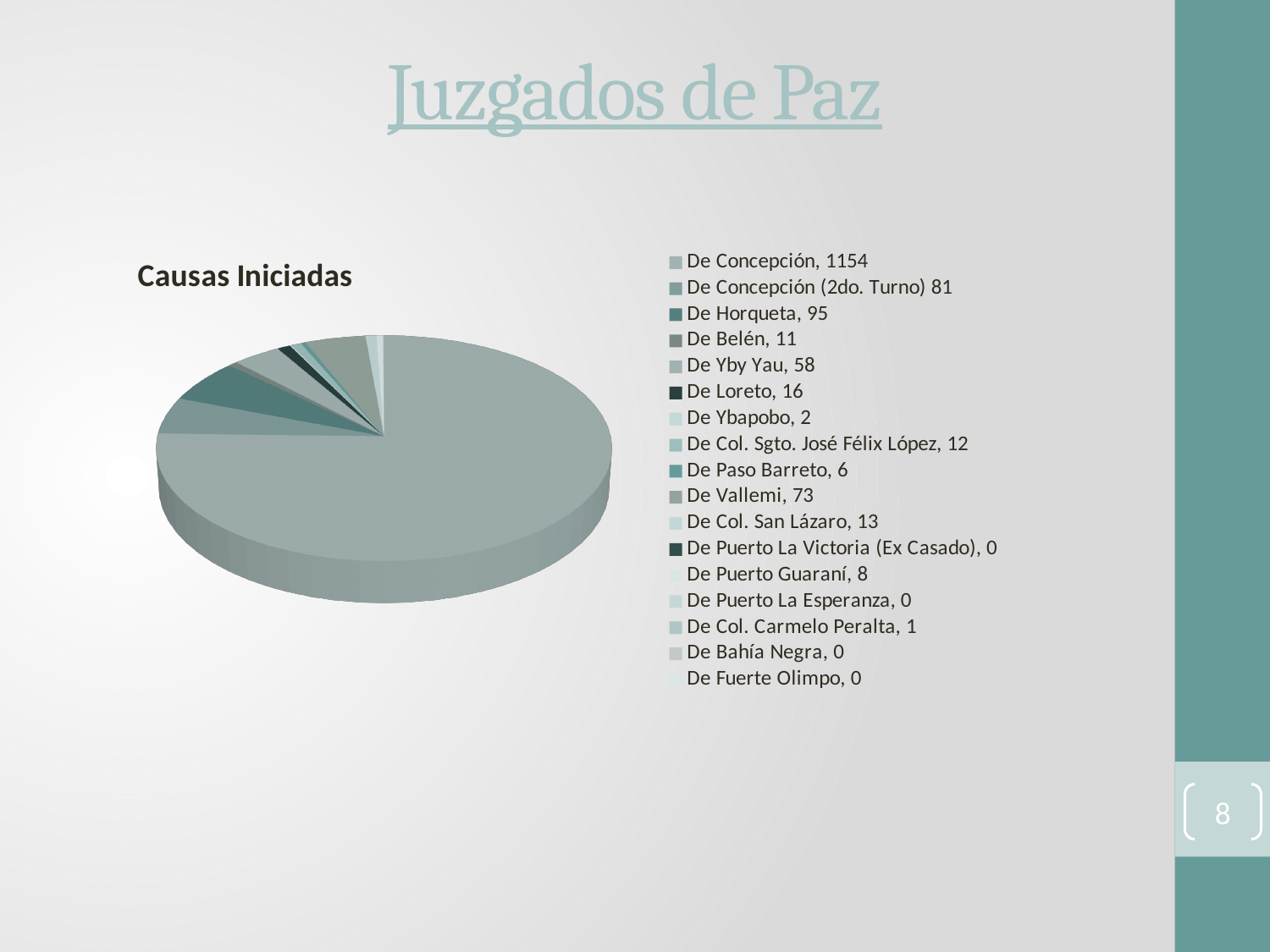
What is the value for De Yby Yau? 58 What type of chart is shown on the slide? pie chart What is the value for De Vallemi? 73 What is the title of the chart? Causas Iniciadas Which is larger, De Horqueta or De Concepción (2do. Turno)? De Horqueta Which category has the highest value? De Concepción What is the value for De Puerto Guaraní? 8 What is the difference between De Vallemi and De Yby Yau? 15 How many categories does the legend list? 17 What is the value for De Concepción? 1154 What is the difference between De Concepción and De Horqueta? 1059 What is the value for De Horqueta? 95